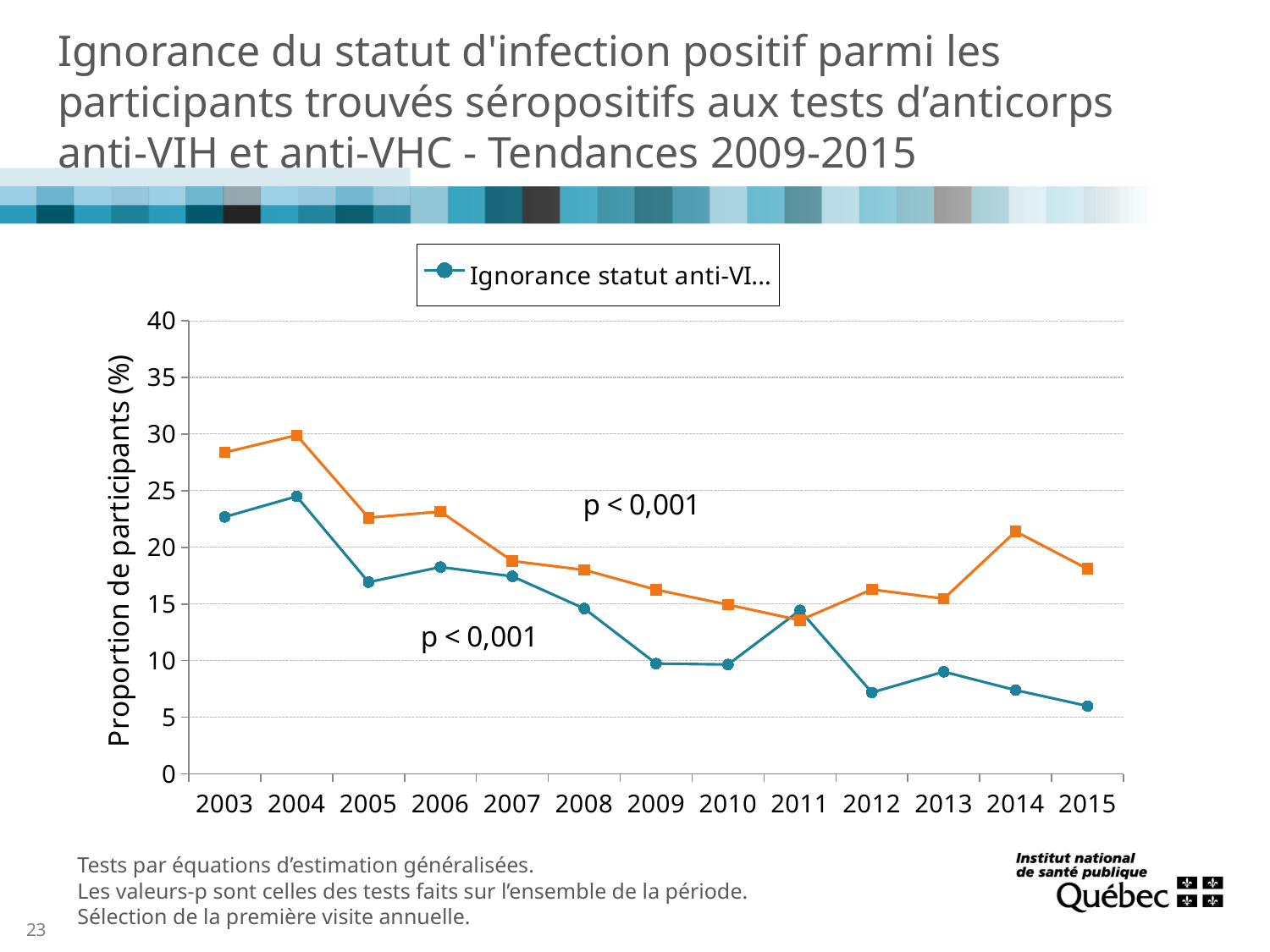
What is the title of the y axis of the chart? Proportion de participants (%) In which year does the teal line with circle markers reach its highest value? 2004 What kind of chart is shown on the slide? line chart In which year does the orange line with square markers reach its highest value? 2004 Is the value of the orange line with square markers in 2014 greater or less than 20? greater What is the last year shown on the x axis of the chart? 2015 What p-value annotation is written on the chart next to each line? p < 0,001 In which year does the orange line with square markers reach its lowest value? 2011 How many years are plotted along the x axis of the chart? 13 In which year does the teal line with circle markers reach its lowest value? 2015 Is the value of the teal line with circle markers in 2015 greater or less than 10? less What is the first year shown on the x axis of the chart? 2003